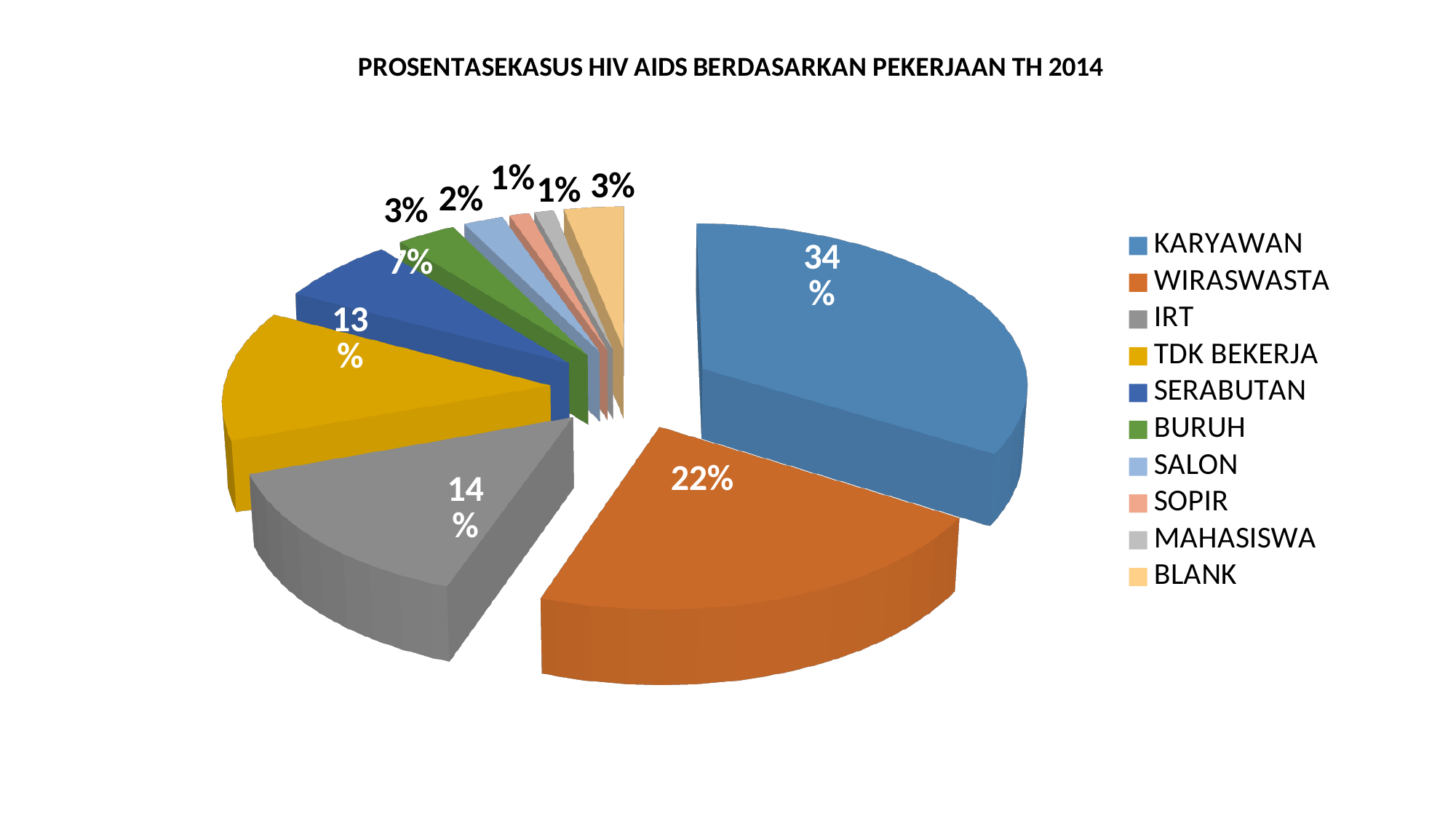
What percentage of the pie is WIRASWASTA? 22% What colour is the BURUH slice? green What percentage of the pie is KARYAWAN? 34% What is the difference between the KARYAWAN and WIRASWASTA shares? 12% What percentage of the pie is SERABUTAN? 7% What is the title of the chart? PROSENTASEKASUS HIV AIDS BERDASARKAN PEKERJAAN TH 2014 Which category has the largest share of the pie? KARYAWAN How many categories does the legend list? 10 What kind of chart is shown on the slide? pie chart What percentage of the pie is IRT? 14% What percentage of the pie is TDK BEKERJA? 13% Which is larger, the share for IRT or the share for TDK BEKERJA? IRT